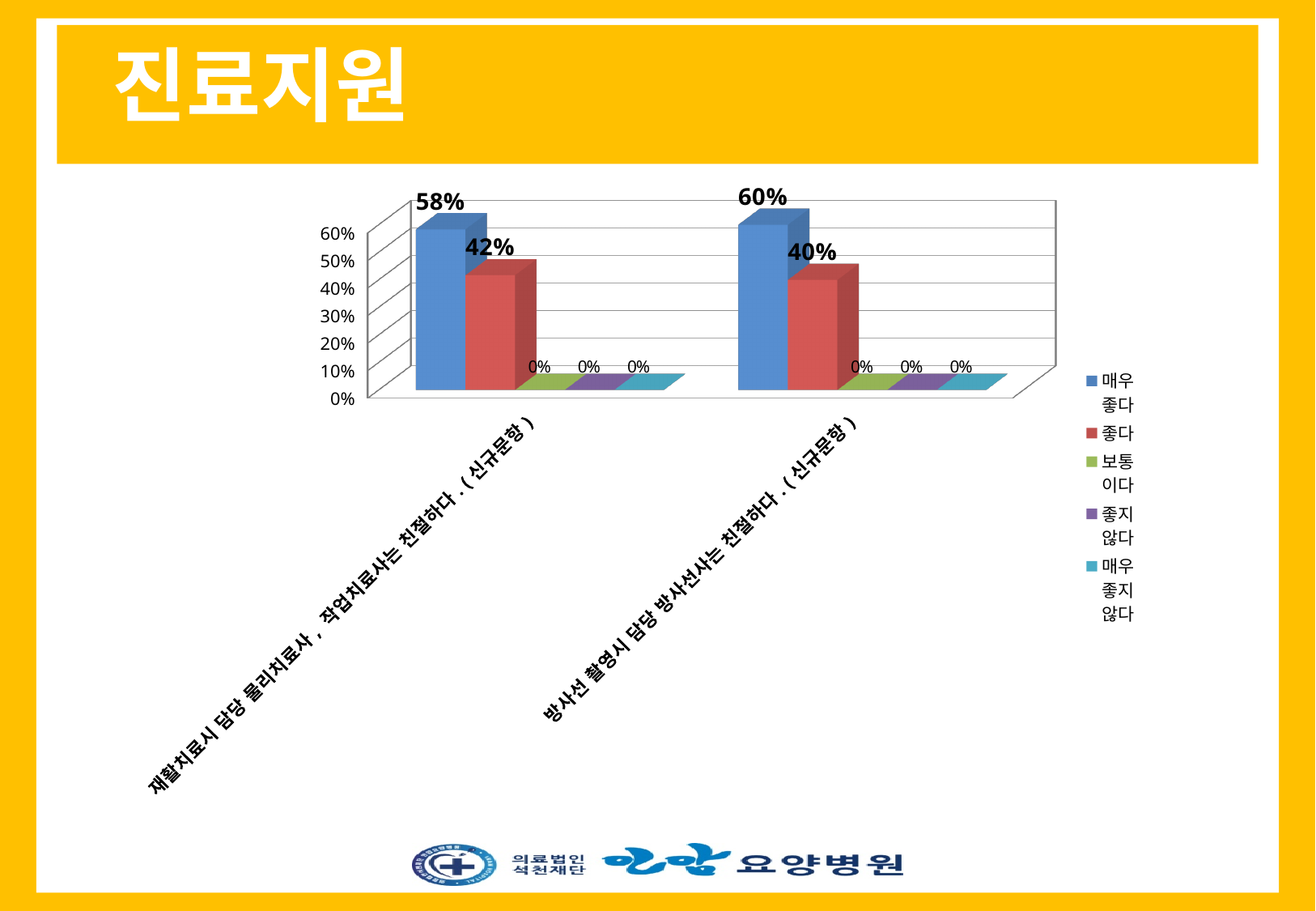
Which category has the higher value for 매우 좋다? 방사선 촬영시 담당 방사선사는 친절하다. (신규문항) What is the difference between the 매우 좋다 and 좋다 values in the category 재활치료시 담당 물리치료사, 작업치료사는 친절하다. (신규문항)? 16% Which category has the lower value for 좋다? 방사선 촬영시 담당 방사선사는 친절하다. (신규문항) What is the difference between the 매우 좋다 values of the two categories? 2% What is the value for 매우 좋다 in the category 재활치료시 담당 물리치료사, 작업치료사는 친절하다. (신규문항)? 58% What is the value for 보통이다 in the category 재활치료시 담당 물리치료사, 작업치료사는 친절하다. (신규문항)? 0% Is the 좋다 value for 재활치료시 담당 물리치료사, 작업치료사는 친절하다. (신규문항) larger or smaller than the 매우 좋다 value for the same category? smaller How many series does the legend list? 5 What is the value for 매우 좋다 in the category 방사선 촬영시 담당 방사선사는 친절하다. (신규문항)? 60% How many categories are shown on the x axis? 2 What kind of chart is shown on the slide? bar chart What is the value for 좋다 in the category 방사선 촬영시 담당 방사선사는 친절하다. (신규문항)? 40%